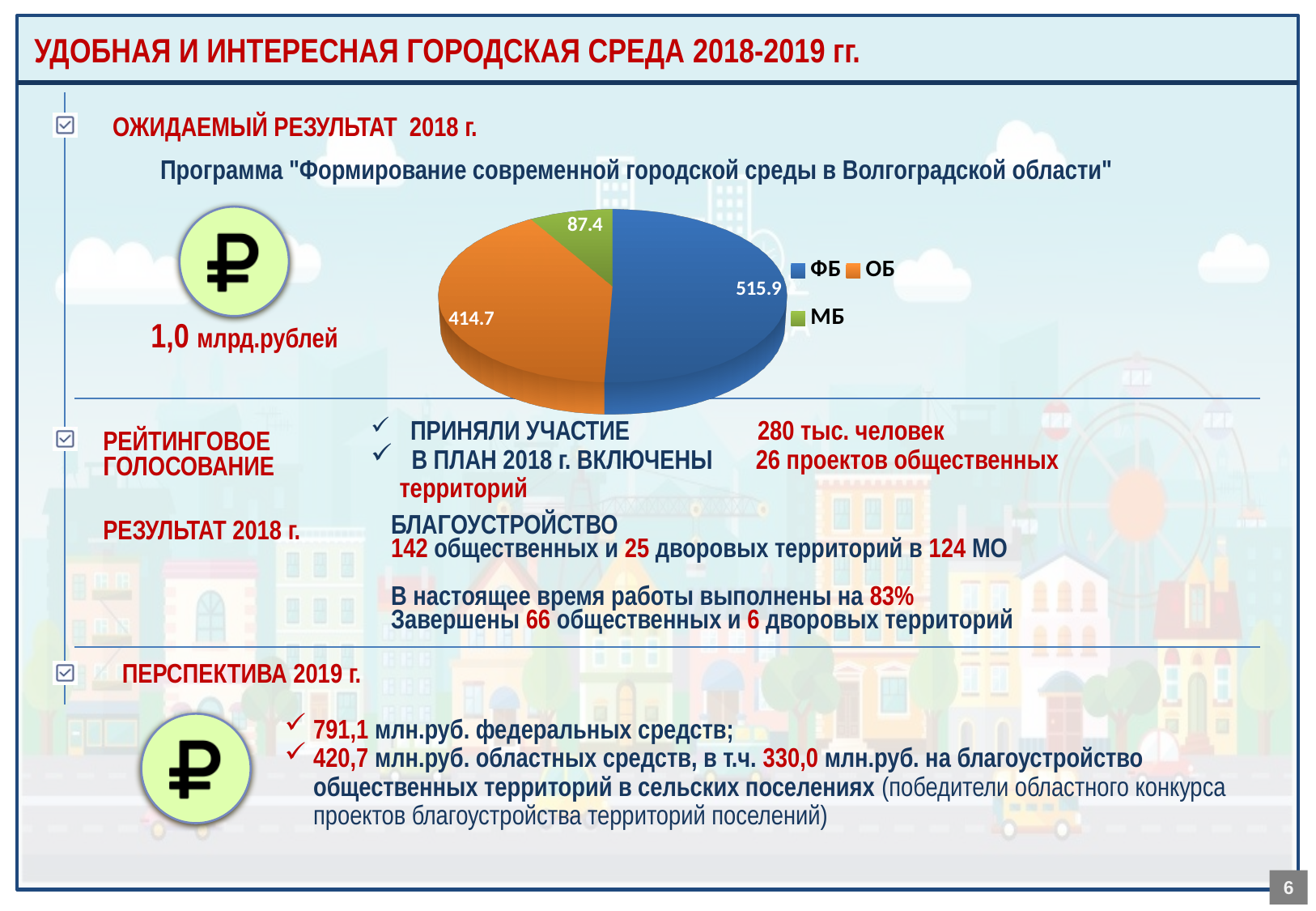
What is the value of the ФБ slice in the pie chart? 515.9 What colour is the ОБ slice in the pie chart? orange How many slices does the pie chart have? 3 How many entries does the pie chart legend list? 3 What is the difference between the ФБ and ОБ values in the pie chart? 101.2 Which is larger in the pie chart, ОБ or МБ? ОБ Which category has the smallest slice in the pie chart? МБ What is the value of the ОБ slice in the pie chart? 414.7 What is the value of the МБ slice in the pie chart? 87.4 What type of chart is shown on the slide? pie chart Which category has the largest slice in the pie chart? ФБ What is the difference between the ОБ and МБ values in the pie chart? 327.3